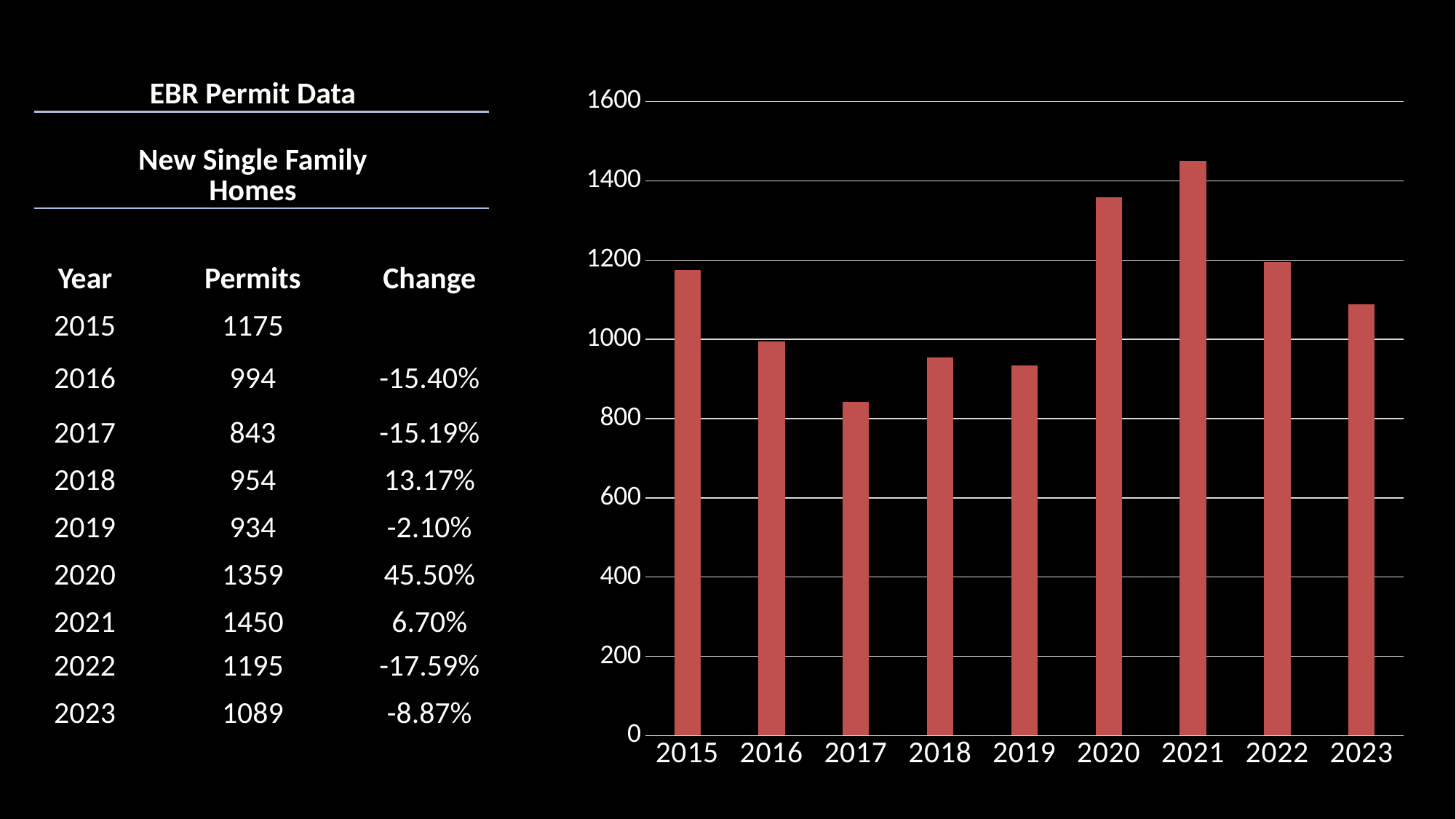
Is the value for 2020 greater or less than 1200? greater What is the difference in permits between 2021 and 2022? 255 Which year has the highest number of permits on the chart? 2021 What kind of chart is shown on the slide? bar chart Which year has the lowest number of permits on the chart? 2017 Is the value for 2016 greater or less than 1000? less How many permits were issued in 2017? 843 Do the permit values rise or fall from 2015 to 2017? fall Which year had more permits, 2015 or 2023? 2015 How many years are plotted on the bar chart? 9 How many permits were issued in 2020? 1359 What is the percentage change in permits shown for 2020? 45.50%